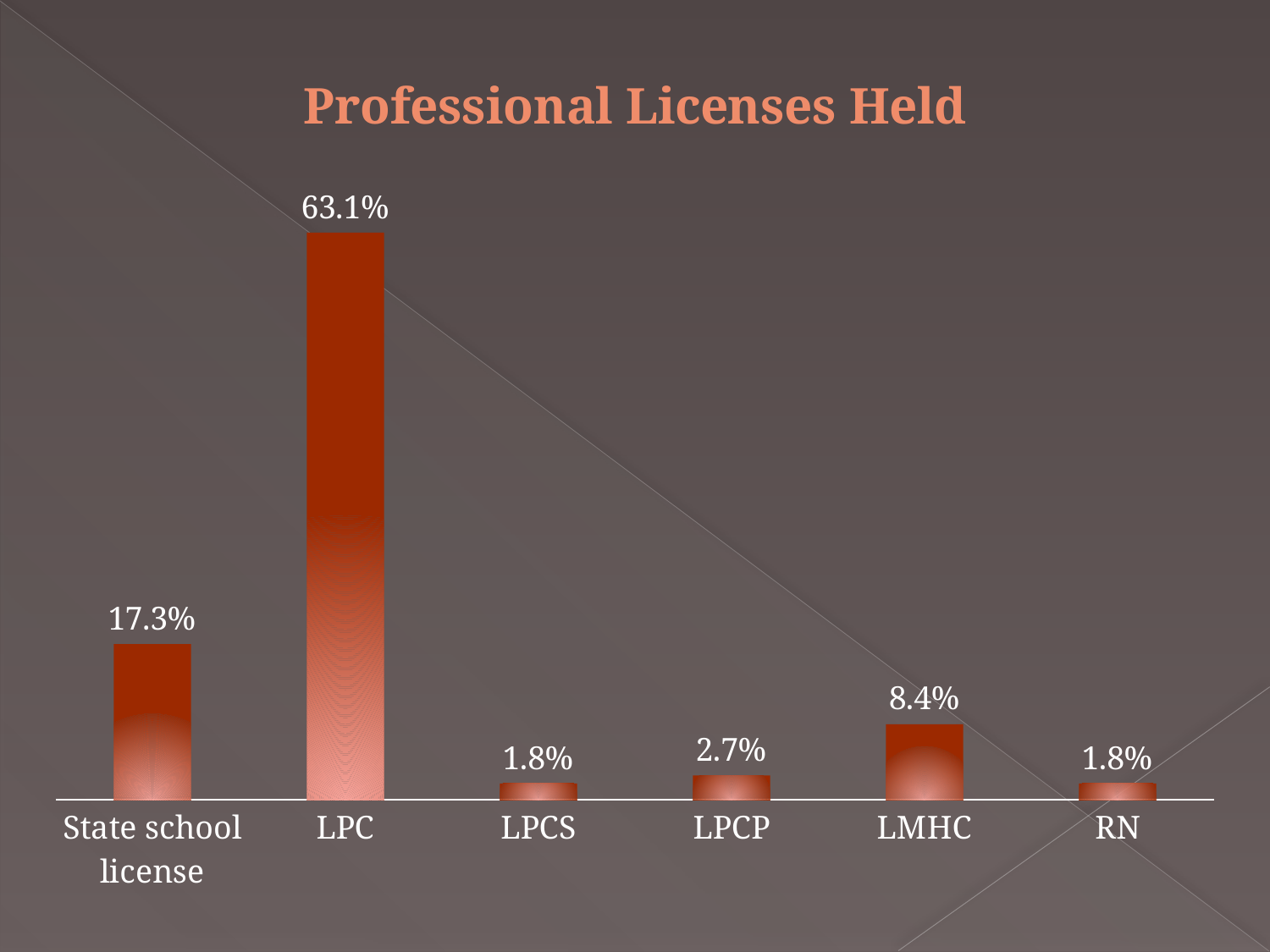
Which is larger, the value for State school license or the value for LMHC? State school license What is the value for LPCP? 2.7% What is the difference between the LMHC value and the LPCP value? 5.7% What percentage holds an LPC license? 63.1% What is the value for LMHC? 8.4% What is the value for State school license? 17.3% What is the difference between the LPC value and the State school license value? 45.8% What kind of chart is shown on the slide? Bar chart Which license category has the highest value? LPC What is the title of the chart? Professional Licenses Held How many license categories are shown on the chart? 6 Which is larger, the value for LMHC or the value for LPCP? LMHC